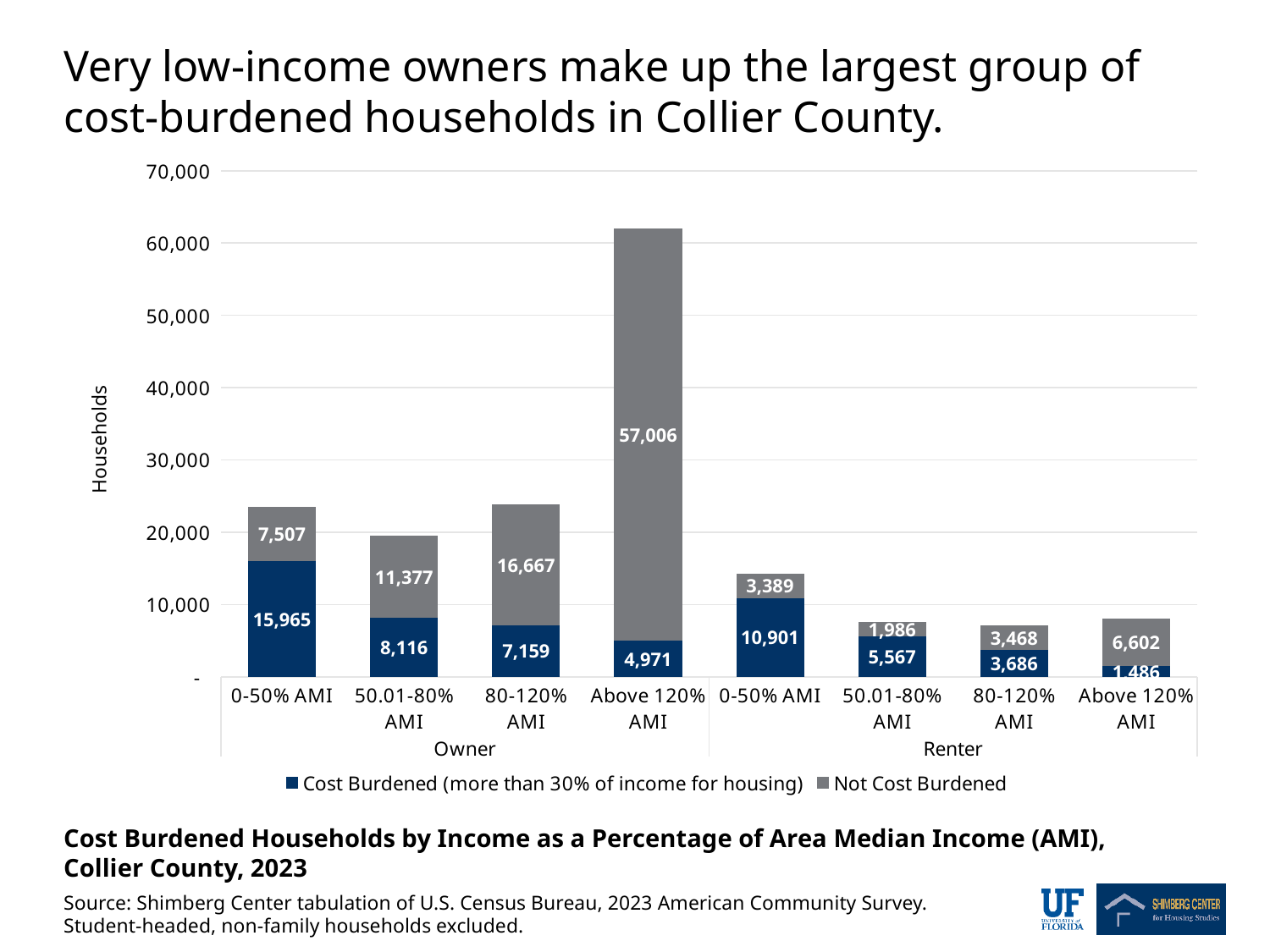
How many cost-burdened owner households are in the 0-50% AMI group? 15,965 Which is larger: the number of cost-burdened renter households at 80-120% AMI or the number of not-cost-burdened renter households at 80-120% AMI? Cost burdened (3,686) How many cost-burdened renter households are in the 50.01-80% AMI group? 5,567 Which income group has the largest number of cost-burdened households? Owner, 0-50% AMI How many not-cost-burdened owner households are in the Above 120% AMI group? 57,006 What is the difference between cost-burdened owner households at 0-50% AMI and cost-burdened renter households at 0-50% AMI? 5,064 What type of chart is shown on the slide? Stacked bar chart How many series does the legend list? 2 Which income group has the smallest number of cost-burdened households? Renter, Above 120% AMI How many income-group bars are shown in the chart? 8 What is the total number of households in the Renter 0-50% AMI bar? 14,290 Is the total height of the Owner Above 120% AMI bar greater or less than 60,000? greater